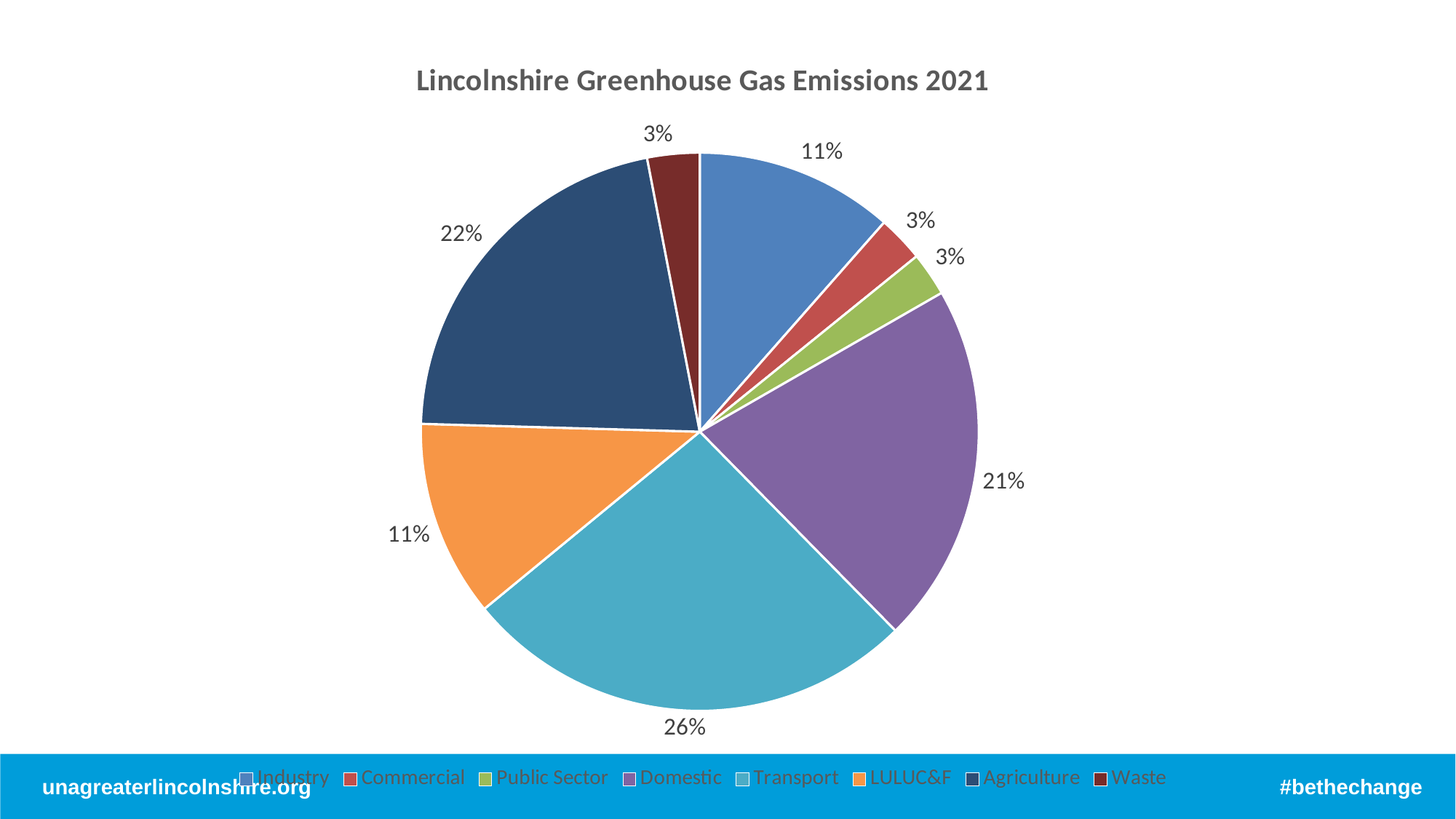
What is the title of the pie chart? Lincolnshire Greenhouse Gas Emissions 2021 Which is larger, the share for Agriculture or the share for Industry? Agriculture Which category has the largest share of emissions? Transport What share of emissions does Waste account for? 3% What is the difference between the Transport share and the Domestic share? 5% What percentage of emissions comes from Agriculture? 22% What type of chart is shown on the slide? Pie chart What is the value shown for Domestic? 21% How many categories does the legend list? 8 What share of emissions does Transport account for? 26% What is the combined share of Industry and LULUC&F? 22% What percentage is shown for LULUC&F? 11%